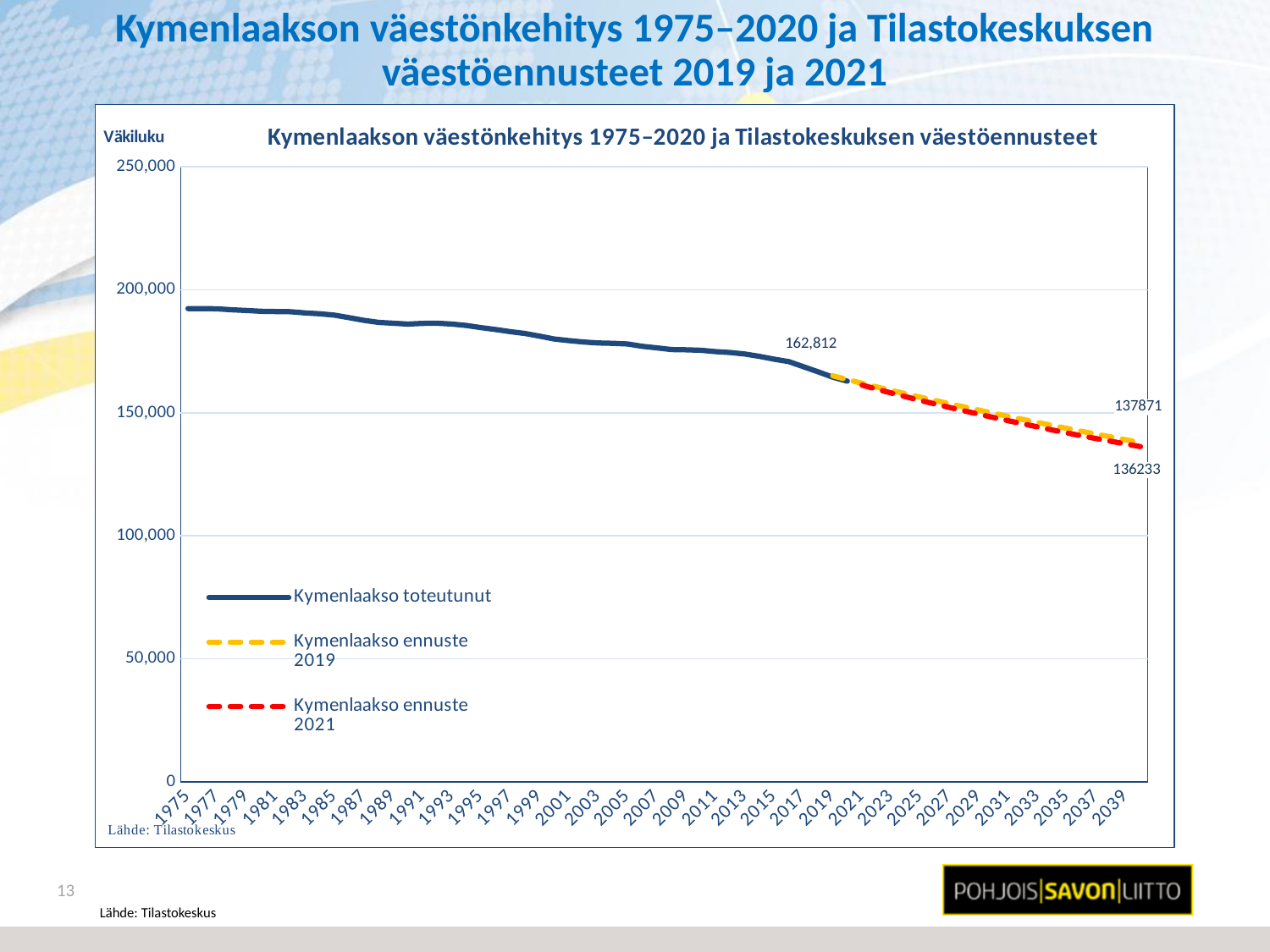
Which forecast line ends at a higher value, Kymenlaakso ennuste 2019 or Kymenlaakso ennuste 2021? Kymenlaakso ennuste 2019 What is the labelled value at the end of the Kymenlaakso ennuste 2019 line? 137871 What is the difference between the labelled value 162,812 on the Kymenlaakso toteutunut line and the end value 137871 of the Kymenlaakso ennuste 2019 line? 24,941 Is the value of the Kymenlaakso toteutunut line in 1975 greater or less than 200,000? less What is the labelled value at the end of the Kymenlaakso toteutunut line? 162,812 What is the difference between the end values of the Kymenlaakso ennuste 2019 line (137871) and the Kymenlaakso ennuste 2021 line (136233)? 1638 What type of chart is shown on the slide? line chart What is the labelled value at the end of the Kymenlaakso ennuste 2021 line? 136233 How many series does the chart legend list? 3 Does the Kymenlaakso toteutunut line rise or fall from 1975 to 2020? fall Is the value of the Kymenlaakso toteutunut line in 2001 greater or less than 150,000? greater What label is shown on the vertical axis of the chart? Väkiluku